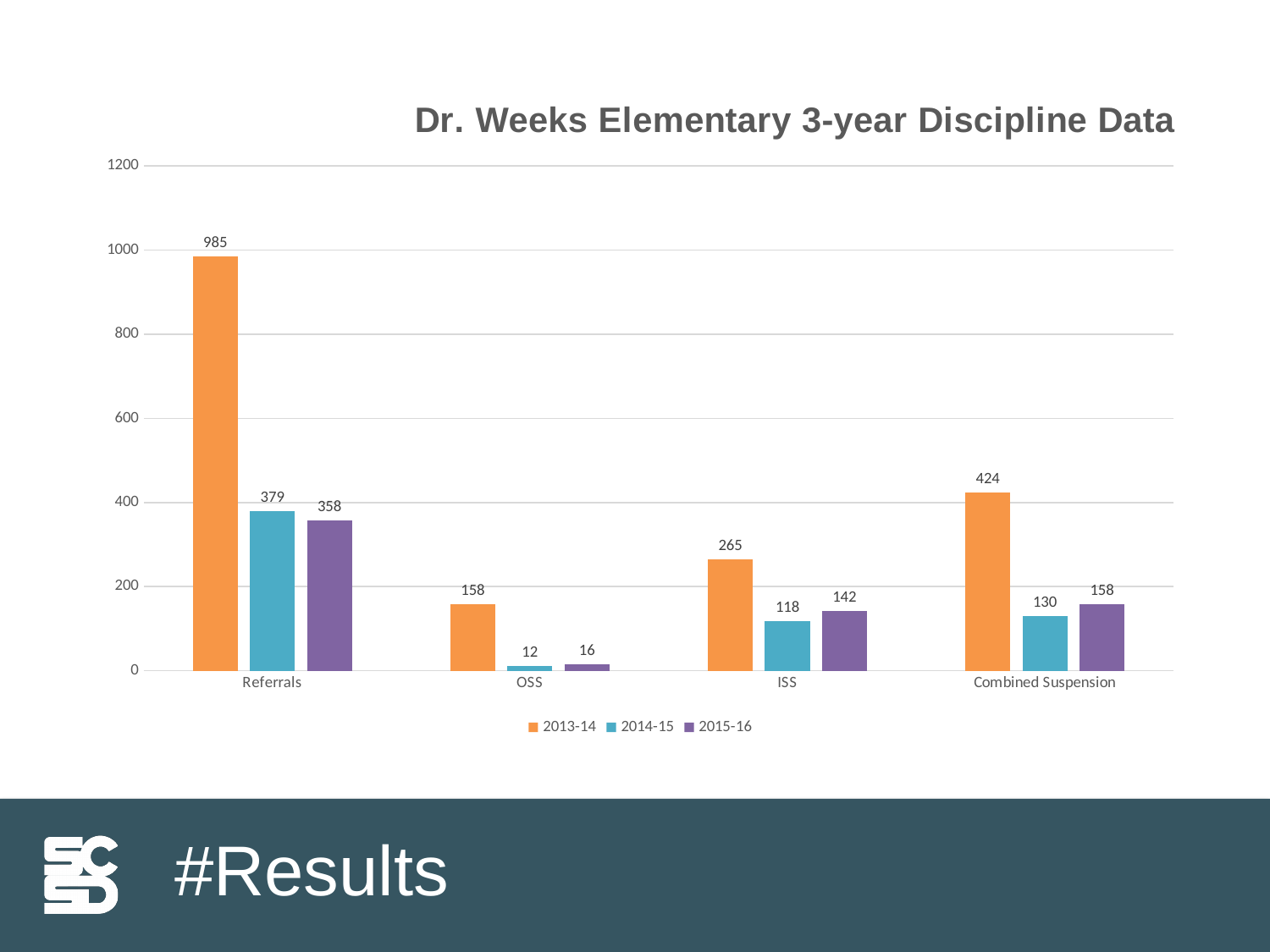
What is the ISS value for 2014-15? 118 Which category has the lowest value in 2014-15? OSS What is the difference between Referrals in 2013-14 and Referrals in 2014-15? 606 What is the OSS value for 2015-16? 16 What is the Combined Suspension value for 2013-14? 424 What kind of chart is shown on the slide? Bar chart What is the number of Referrals in 2013-14? 985 Which is larger: ISS in 2015-16 or Combined Suspension in 2015-16? Combined Suspension in 2015-16 How many series does the legend list? 3 What is the title of the chart? Dr. Weeks Elementary 3-year Discipline Data How many categories are shown on the x axis? 4 Which category has the highest value in 2013-14? Referrals